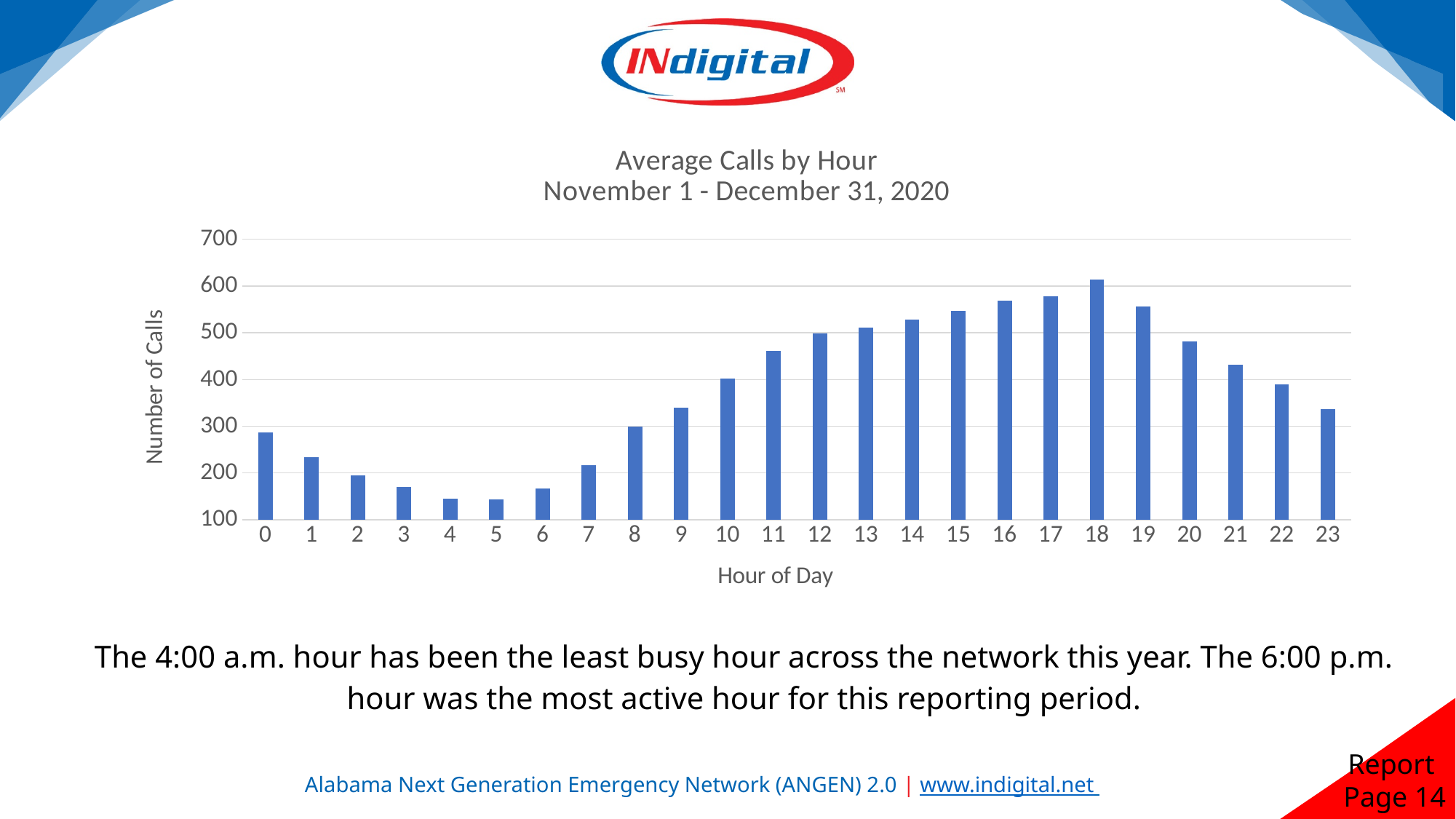
Which has more calls, hour 17 or hour 19? 17 Do the values rise or fall from hour 6 to hour 18? rise Which has more calls, hour 11 or hour 21? 11 Is the value for hour 20 greater or less than 500? less Is the value for hour 16 greater or less than 500? greater What kind of chart is shown on the slide? Bar chart How many hours (categories) are plotted on the x axis? 24 Which hour of day has the highest number of calls? 18 Is the value for hour 9 greater or less than 300? greater What is the label of the y axis? Number of Calls